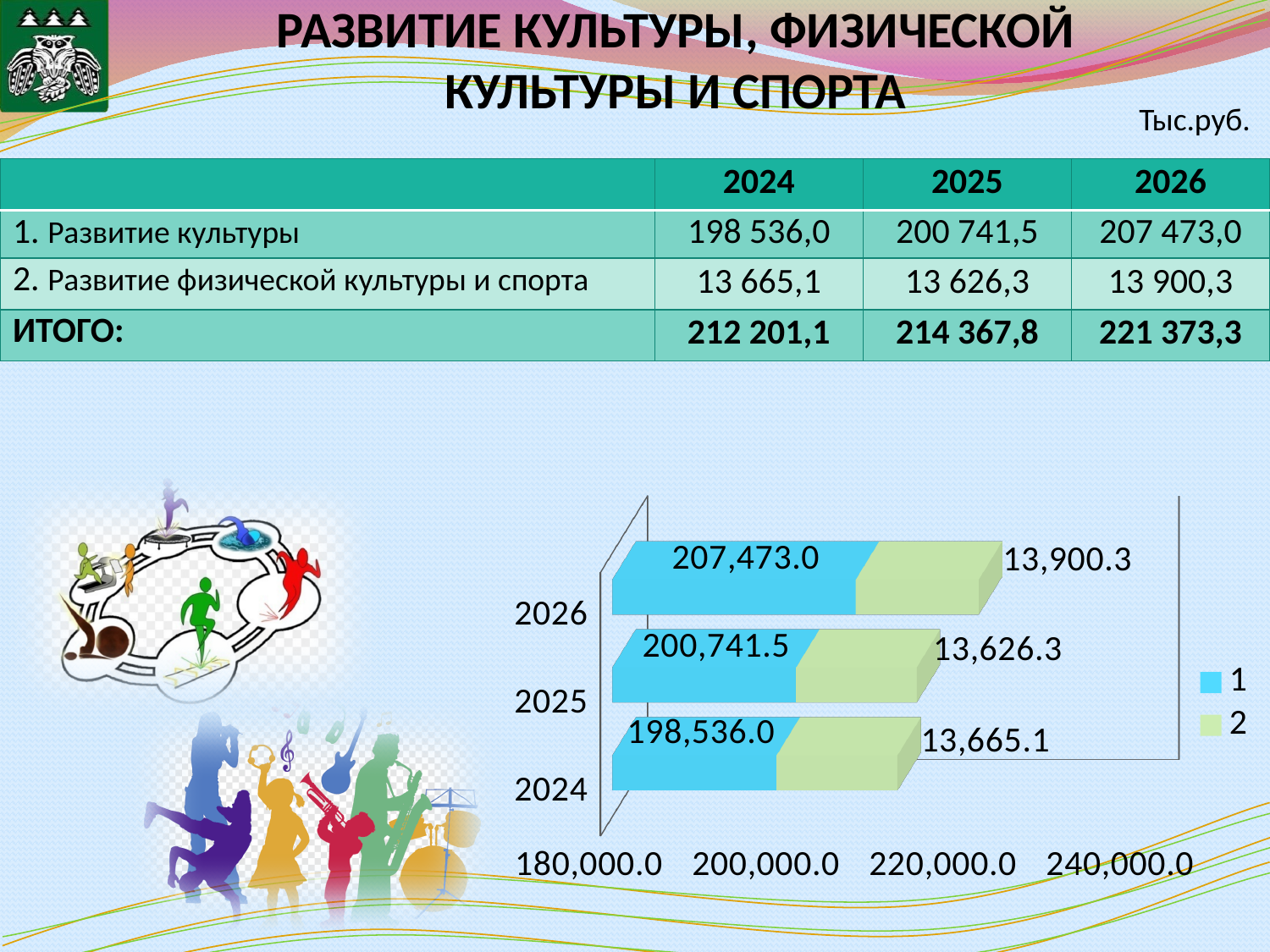
What is the value of series 2 for 2025 on the chart? 13,626.3 What is the value of series 2 for 2024 on the chart? 13,665.1 In which year is the value of series 2 lowest on the chart? 2025 What is the value of series 1 for 2025 on the chart? 200,741.5 How many series does the chart legend list? 2 How many categories (years) are shown on the chart's vertical axis? 3 Which is larger on the chart: the series 2 value for 2026 or for 2024? 2026 What is the value of series 1 for 2026 on the chart? 207,473.0 What kind of chart is shown on the slide? bar chart What is the total of the stacked bar for 2026 on the chart? 221,373.3 In which year is the value of series 1 highest on the chart? 2026 What is the difference between the series 1 values for 2026 and 2024 on the chart? 8,937.0